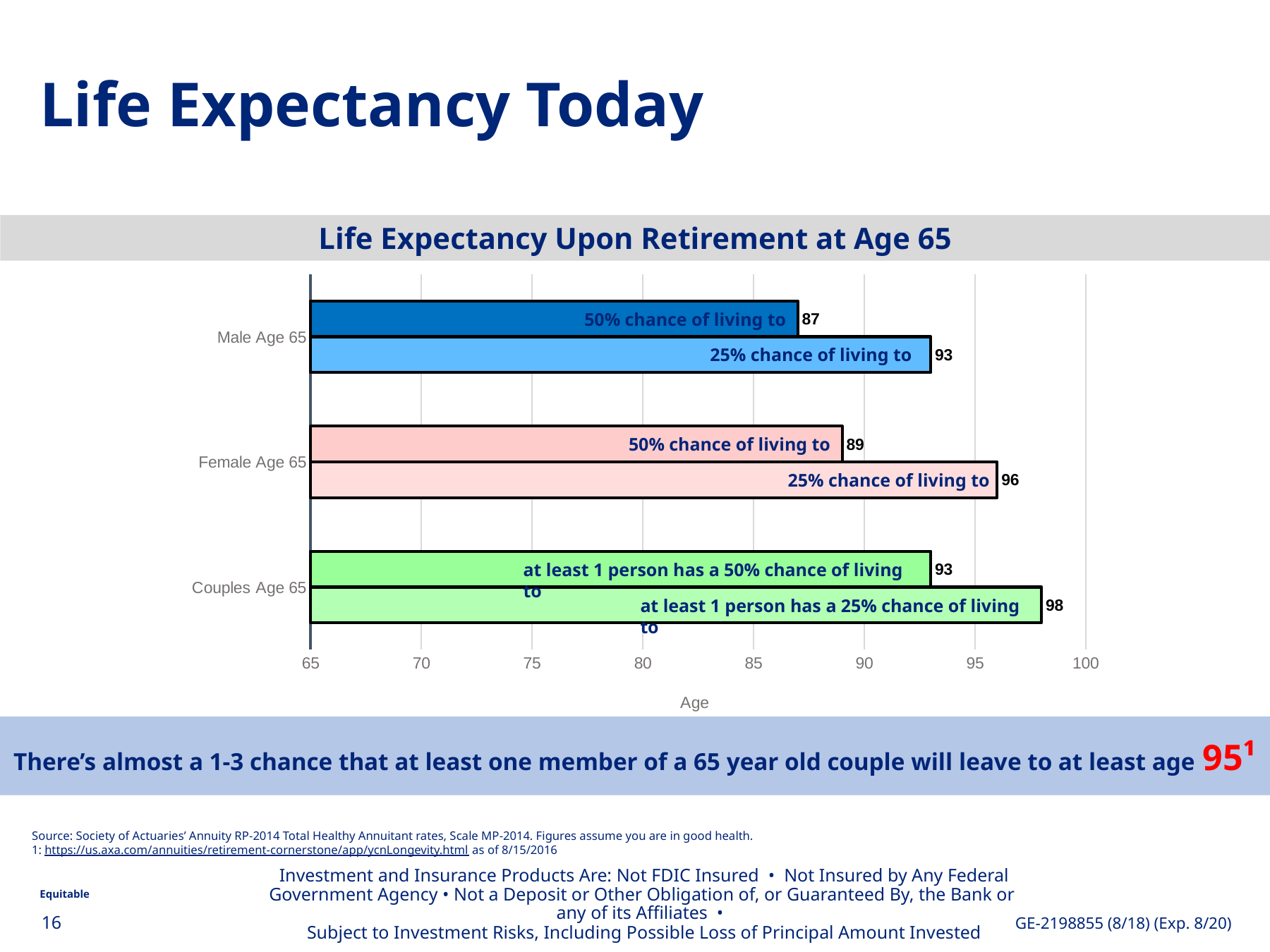
How many categories are shown on the vertical axis of the chart? 3 For couples age 65, what age does at least 1 person have a 50% chance of living to? 93 Is the 25% chance age for Couples Age 65 greater or less than 95? greater What is the label of the horizontal axis? Age Which category has the highest plotted age value? Couples Age 65 (at least 1 person has a 25% chance of living to) Which is larger: the 25% chance age for Male Age 65 or the 50% chance age for Female Age 65? 25% chance age for Male Age 65 What is the title of the chart? Life Expectancy Upon Retirement at Age 65 What type of chart is shown on the slide? bar chart What is the difference between the 25% chance age and the 50% chance age for Female Age 65? 7 What is the age a 65-year-old female has a 25% chance of living to? 96 What is the age a 65-year-old male has a 50% chance of living to? 87 Which bar shows the lowest age value on the chart? Male Age 65, 50% chance of living to